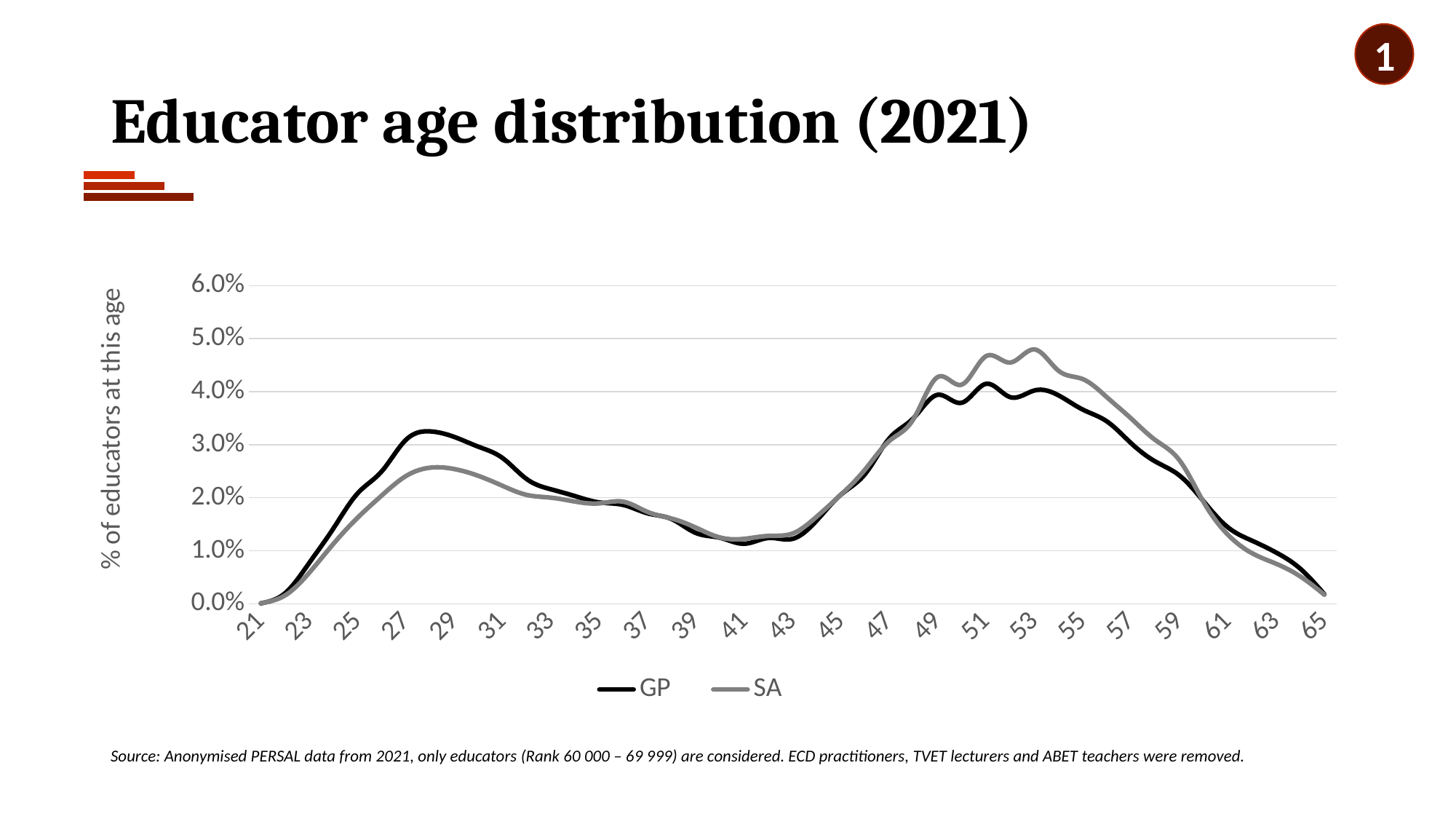
At age 53, which series has the higher value, GP or SA? SA Which series reaches the higher peak value overall? SA Is the SA value at age 65 greater or less than 1.0%? less What kind of chart is shown on the slide? line chart At age 28, which series has the higher value, GP or SA? GP Is the SA value at age 28 greater or less than 3.0%? less Do the SA values rise or fall from age 53 to age 65? fall Is the GP value at age 28 greater or less than 3.0%? greater What is the label on the vertical axis? % of educators at this age What is the title of the chart? Educator age distribution (2021) How many series does the legend list? 2